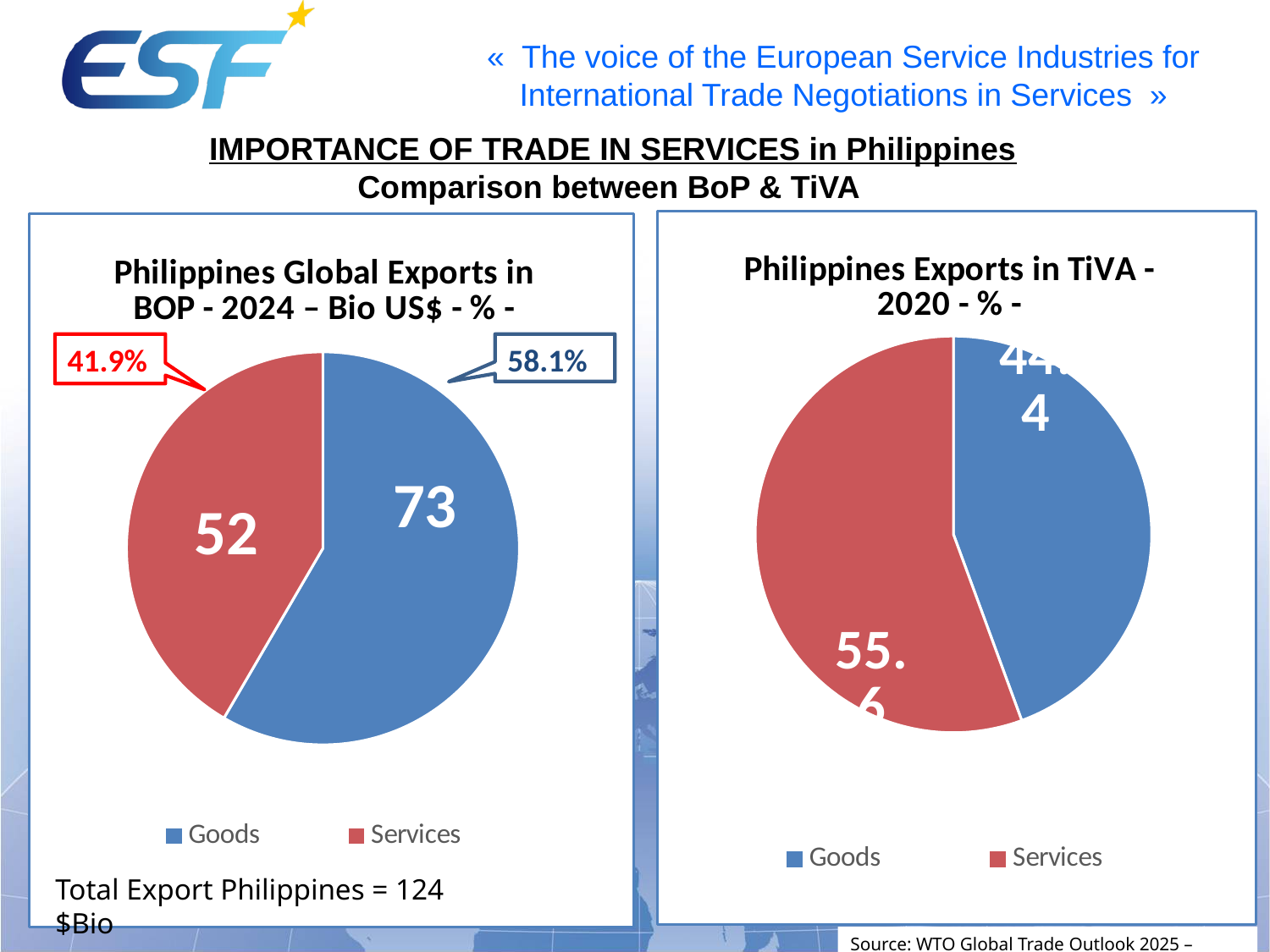
In the 'Philippines Global Exports in BOP - 2024' chart, what is the value for Services? 52 In the 'Philippines Global Exports in BOP - 2024' chart, which category is the largest? Goods How many categories does the legend of the 'Philippines Global Exports in BOP - 2024' chart list? 2 In the 'Philippines Global Exports in BOP - 2024' chart, what colour is the Services slice? Red In the 'Philippines Global Exports in BOP - 2024' chart, what is the difference between the Goods and Services values? 21 In the 'Philippines Exports in TiVA - 2020' chart, which category has the larger slice? Services In the 'Philippines Global Exports in BOP - 2024' chart, what percentage share does the Goods slice have? 58.1% What type of chart is the 'Philippines Exports in TiVA - 2020' chart? Pie chart In the 'Philippines Global Exports in BOP - 2024' chart, what percentage share does the Services slice have? 41.9% In the 'Philippines Exports in TiVA - 2020' chart, which category has the smaller slice? Goods In the 'Philippines Global Exports in BOP - 2024' chart, what is the value for Goods? 73 In the 'Philippines Global Exports in BOP - 2024' chart, which category is the smallest? Services